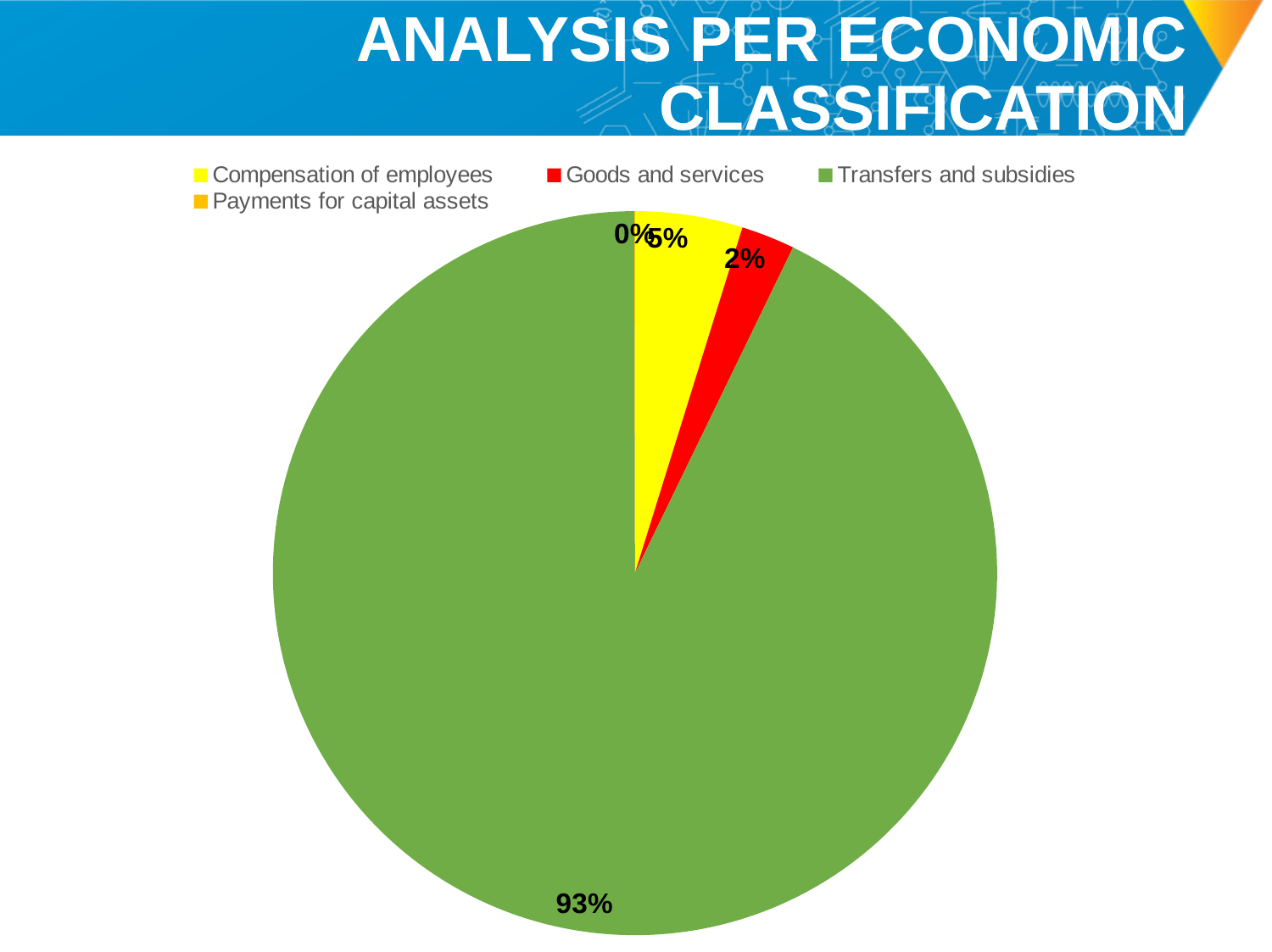
What is the difference in percentage points between Transfers and subsidies and Compensation of employees? 88 How many categories does the legend list? 4 What share of the pie is Payments for capital assets? 0% What kind of chart is shown on the slide? pie chart What share of the pie is Compensation of employees? 5% What is the title of the slide containing the chart? ANALYSIS PER ECONOMIC CLASSIFICATION What share of the pie is Transfers and subsidies? 93% Which category has the smallest slice of the pie? Payments for capital assets Which is larger, Compensation of employees or Goods and services? Compensation of employees What colour is the slice for Goods and services? red Which category has the largest slice of the pie? Transfers and subsidies